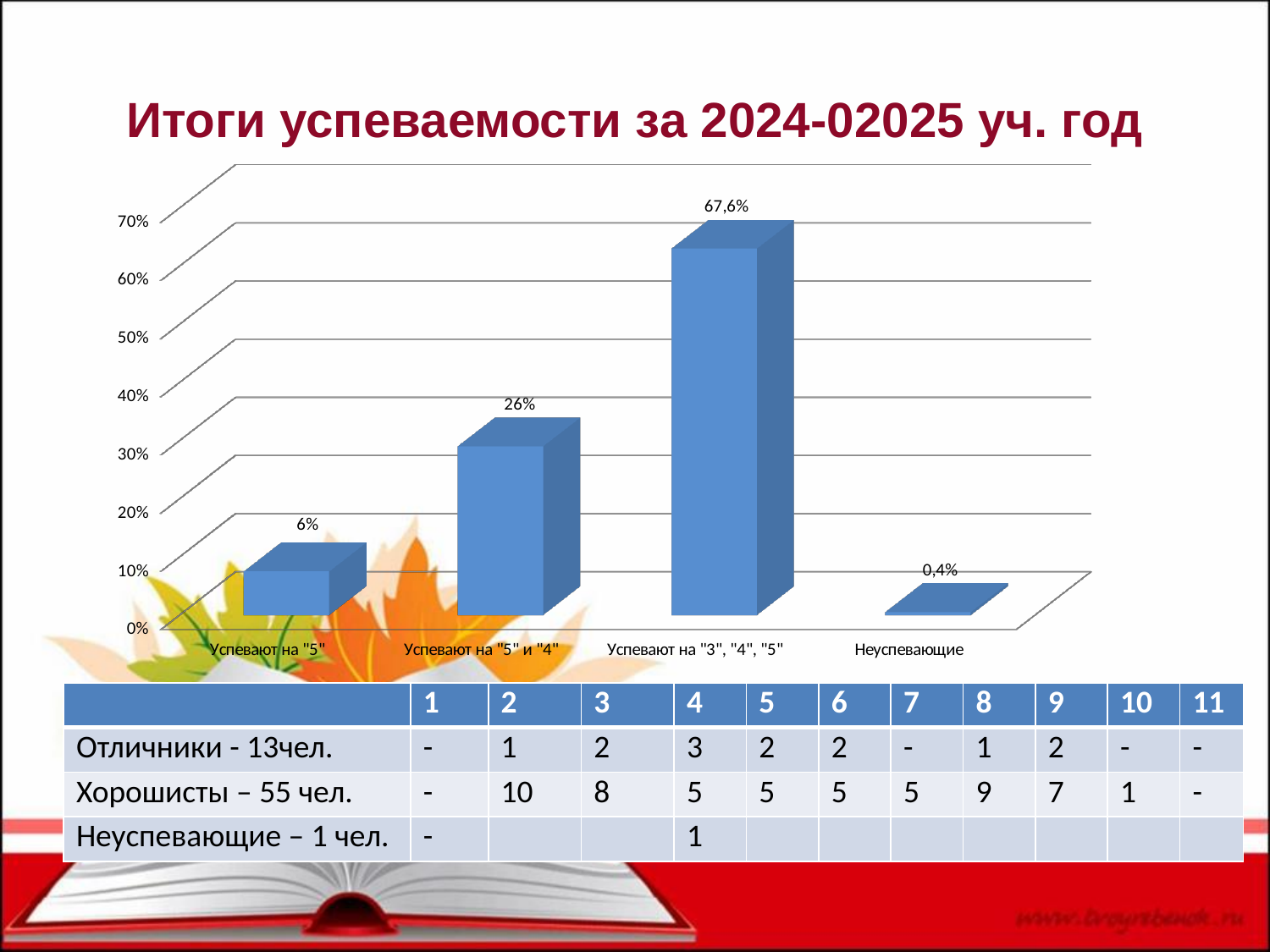
What is the value for Успевают на "5"? 6% What is the value for Успевают на "5" и "4"? 26% Which category has the lowest value? Неуспевающие What is the value for Успевают на "3", "4", "5"? 67,6% What is the value for Неуспевающие? 0,4% How many categories are shown on the chart? 4 What kind of chart is shown on the slide? bar chart What is the difference between the values for Успевают на "5" и "4" and Успевают на "5"? 20% Which is larger: the value for Успевают на "5" or the value for Неуспевающие? Успевают на "5" Which category has the highest value? Успевают на "3", "4", "5" What is the title of the slide containing the chart? Итоги успеваемости за 2024-02025 уч. год Is the value for Успевают на "3", "4", "5" greater or less than 60%? greater